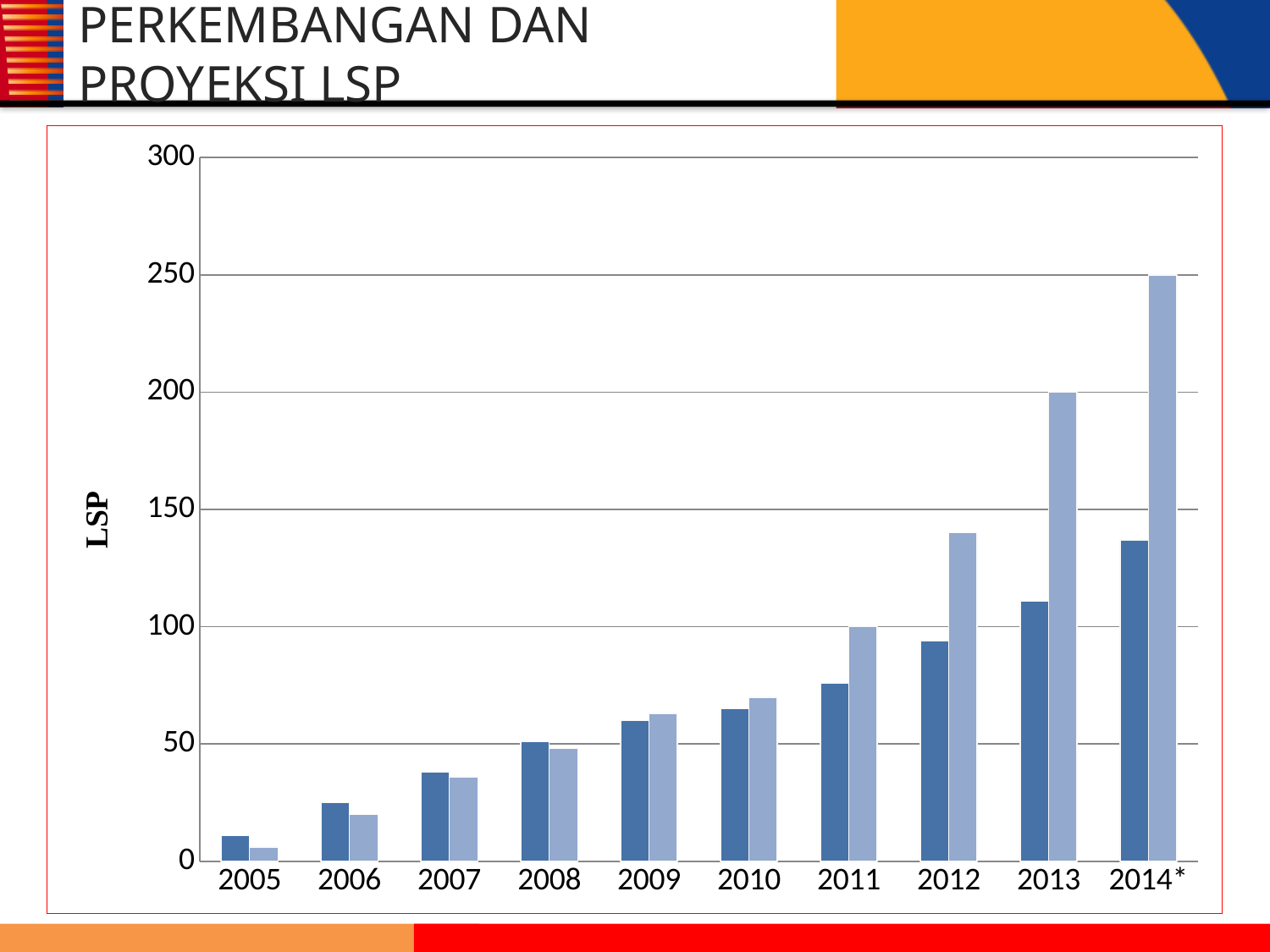
Which year has the shortest bars in the chart? 2005 Which year has the tallest bar in the chart? 2014* Is the value of the light blue bar for 2012 greater or less than 150? less What kind of chart is shown on the slide? bar chart What is the value of the light blue bar for 2011? 100 Is the value of the dark blue bar for 2013 greater or less than 100? greater Is the value of the dark blue bar for 2014* greater or less than 150? less Do the values generally rise or fall from 2005 to 2014*? rise What is the value of the light blue bar for 2014*? 250 How many years are shown along the x axis of the chart? 10 Which is larger for 2014*, the dark blue bar or the light blue bar? the light blue bar What is the value of the light blue bar for 2013? 200